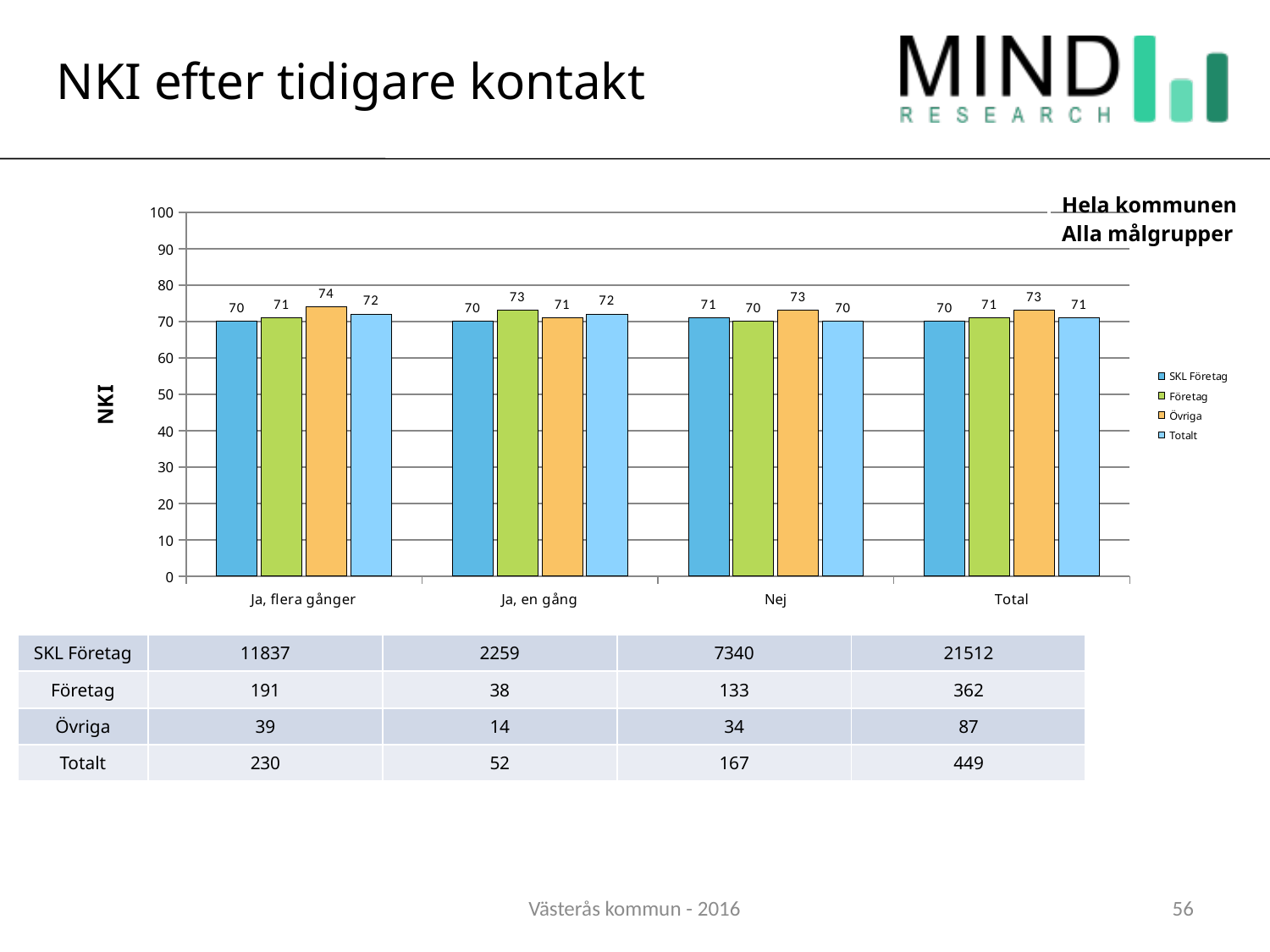
Which series has the lowest NKI value in the 'Ja, en gång' category? SKL Företag How many series does the chart legend list? 4 What is the NKI value for Totalt in the 'Total' category? 71 Which series has the highest NKI value in the 'Ja, flera gånger' category? Övriga What is the difference between the Övriga and SKL Företag values in the 'Ja, flera gånger' category? 4 What is the NKI value for Övriga in the 'Ja, flera gånger' category? 74 What is the label of the y axis of the chart? NKI How many categories are shown on the x axis of the chart? 4 What kind of chart is shown on the slide? Bar chart In the 'Nej' category, which is larger: the value for Övriga or the value for Företag? Övriga What is the NKI value for Företag in the 'Ja, en gång' category? 73 What is the NKI value for SKL Företag in the 'Nej' category? 71